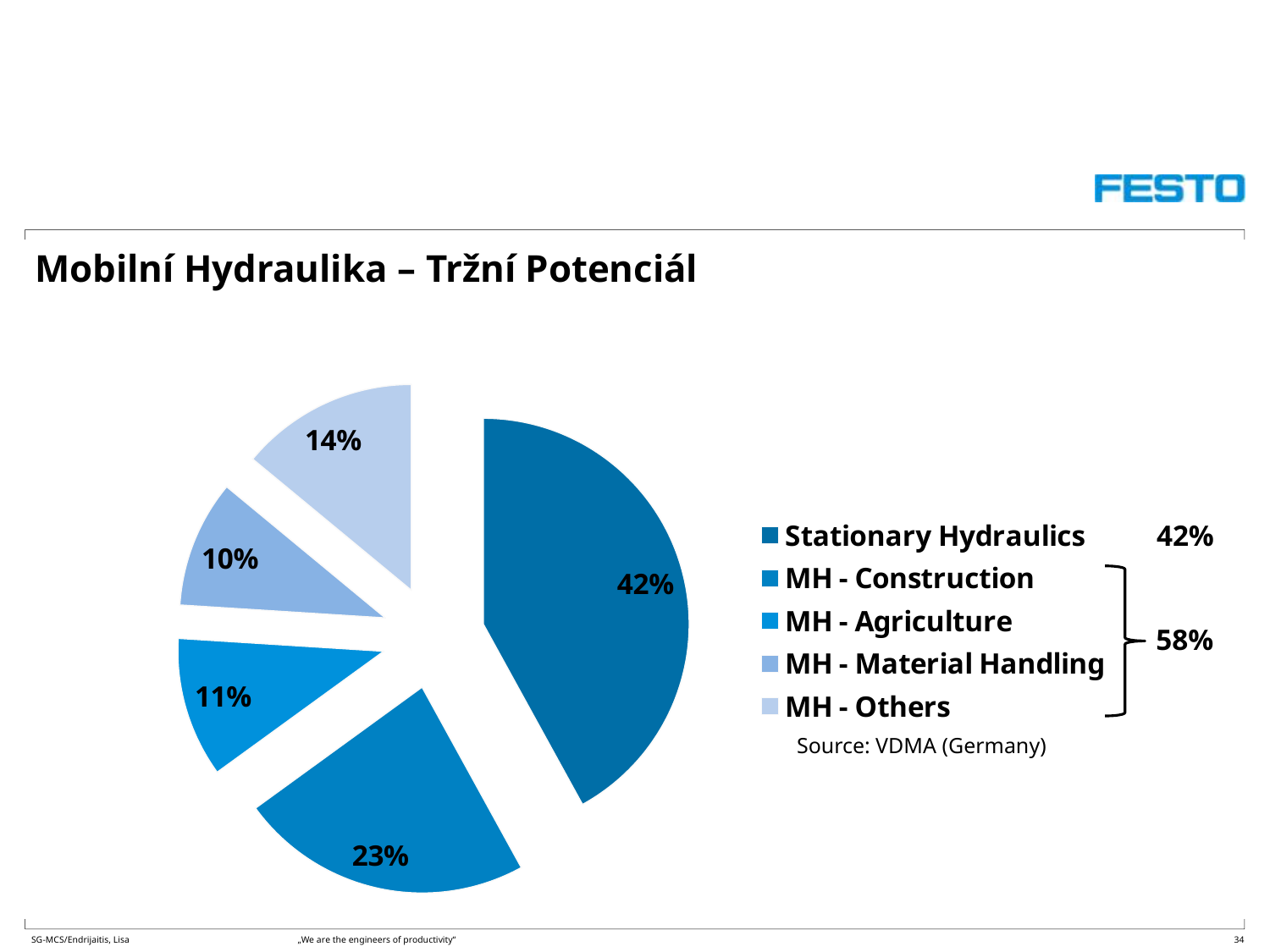
What share of the pie does MH - Others have? 14% What share of the pie does Stationary Hydraulics have? 42% How many entries does the legend list? 5 What is the difference in percentage points between Stationary Hydraulics and MH - Construction? 19 Which category has the largest slice of the pie? Stationary Hydraulics How many slices does the pie chart have? 5 What kind of chart is shown on the slide? Pie chart What share of the pie does MH - Construction have? 23% What share of the pie does MH - Material Handling have? 10% Which category has the smallest slice of the pie? MH - Material Handling What combined share is shown next to the bracket grouping the MH legend entries? 58% Which is larger, the share for MH - Agriculture or the share for MH - Others? MH - Others